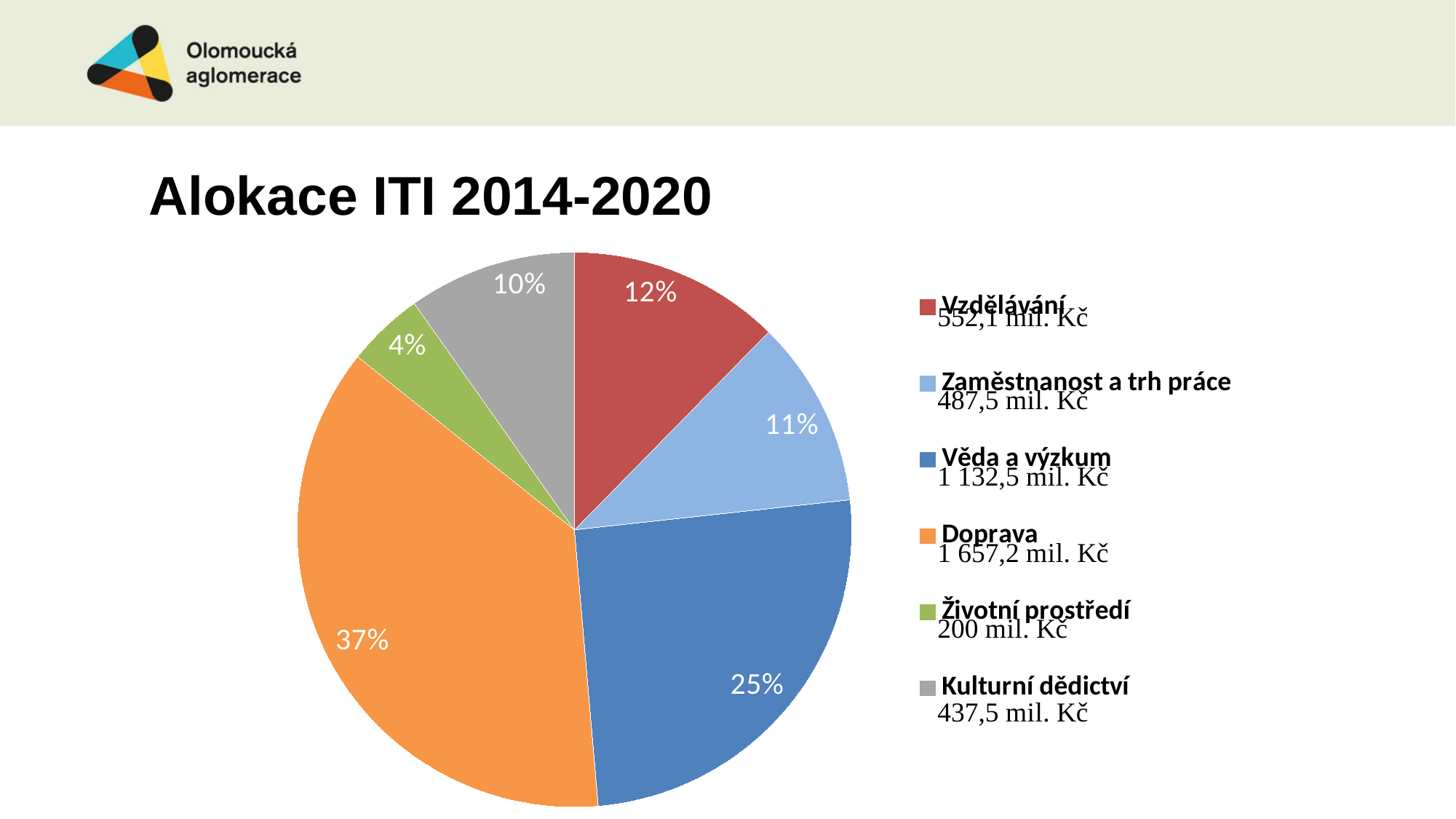
What is the allocation for Vzdělávání according to the legend? 552,1 mil. Kč What is the title of the chart? Alokace ITI 2014-2020 Which is larger, the allocation for Věda a výzkum or for Zaměstnanost a trh práce? Věda a výzkum What type of chart is shown on the slide? pie chart What share of the pie does Doprava represent? 37% What is the difference between the allocations for Doprava and Věda a výzkum? 524,7 mil. Kč Which category has the largest share of the pie? Doprava What share of the pie does Věda a výzkum represent? 25% How many categories does the pie chart have? 6 Which category has the smallest share of the pie? Životní prostředí What is the allocation for Kulturní dědictví according to the legend? 437,5 mil. Kč What share of the pie does Životní prostředí represent? 4%